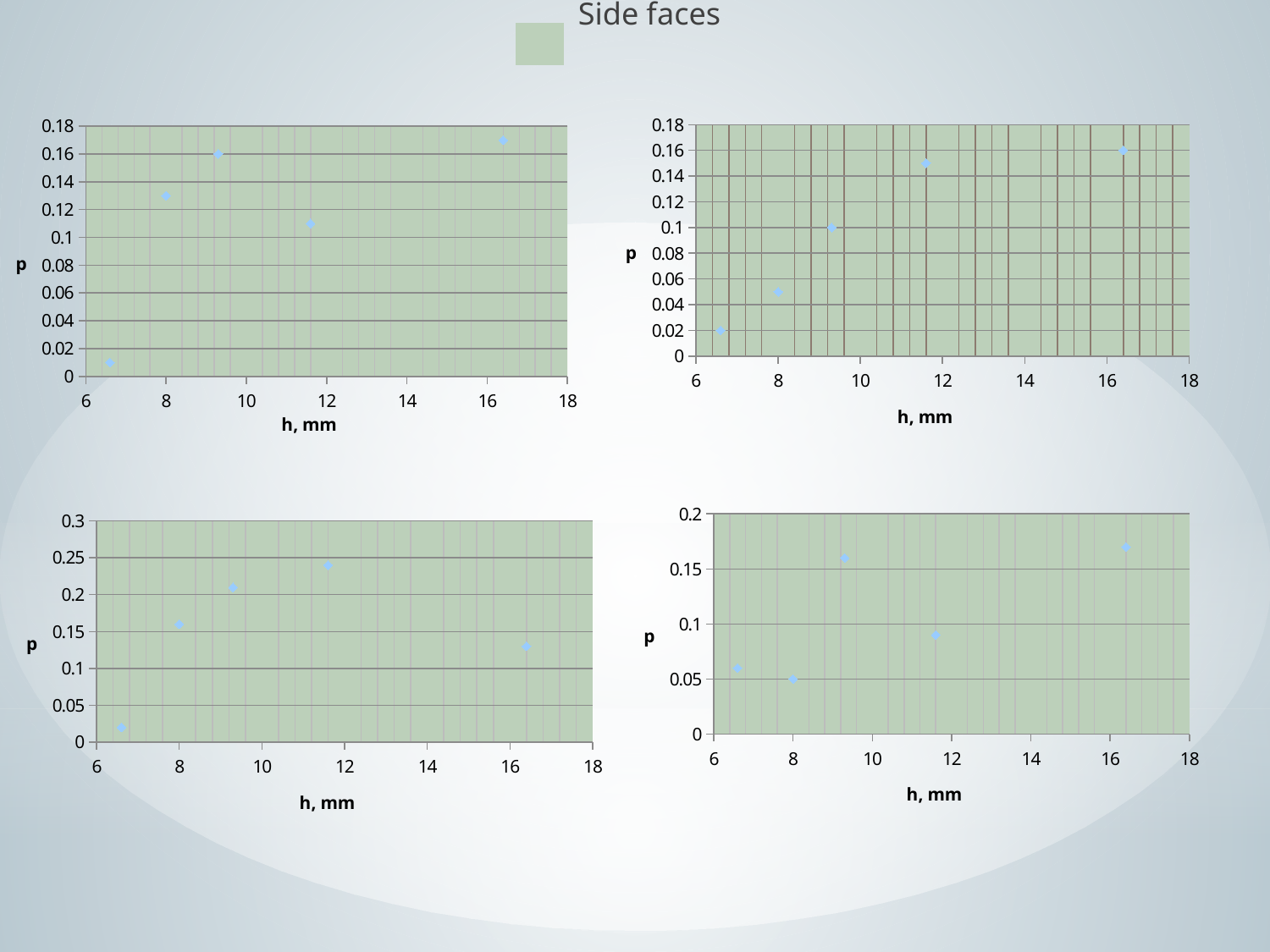
What kind of chart is the top-left chart on the slide? scatter chart What is the label of the horizontal axis on the bottom-right chart? h, mm In the bottom-left chart, which point has the lowest value of p? the point at h ≈ 6.6 mm In the bottom-left chart, is the value of p at h = 16.4 mm greater or less than 0.2? less In the top-right chart, is the value of p at h = 8 mm greater or less than 0.1? less How many data points are plotted in the top-right chart? 5 In the top-right chart, do the values of p rise or fall as h increases? rise In the bottom-right chart, is the value of p at h = 9.3 mm greater or less than 0.1? greater How many data points are plotted in the bottom-left chart? 5 In the bottom-right chart, which is larger: the value of p at h = 9.3 mm or at h = 11.6 mm? h = 9.3 mm In the bottom-left chart, which point has the highest value of p? the point at h ≈ 11.6 mm